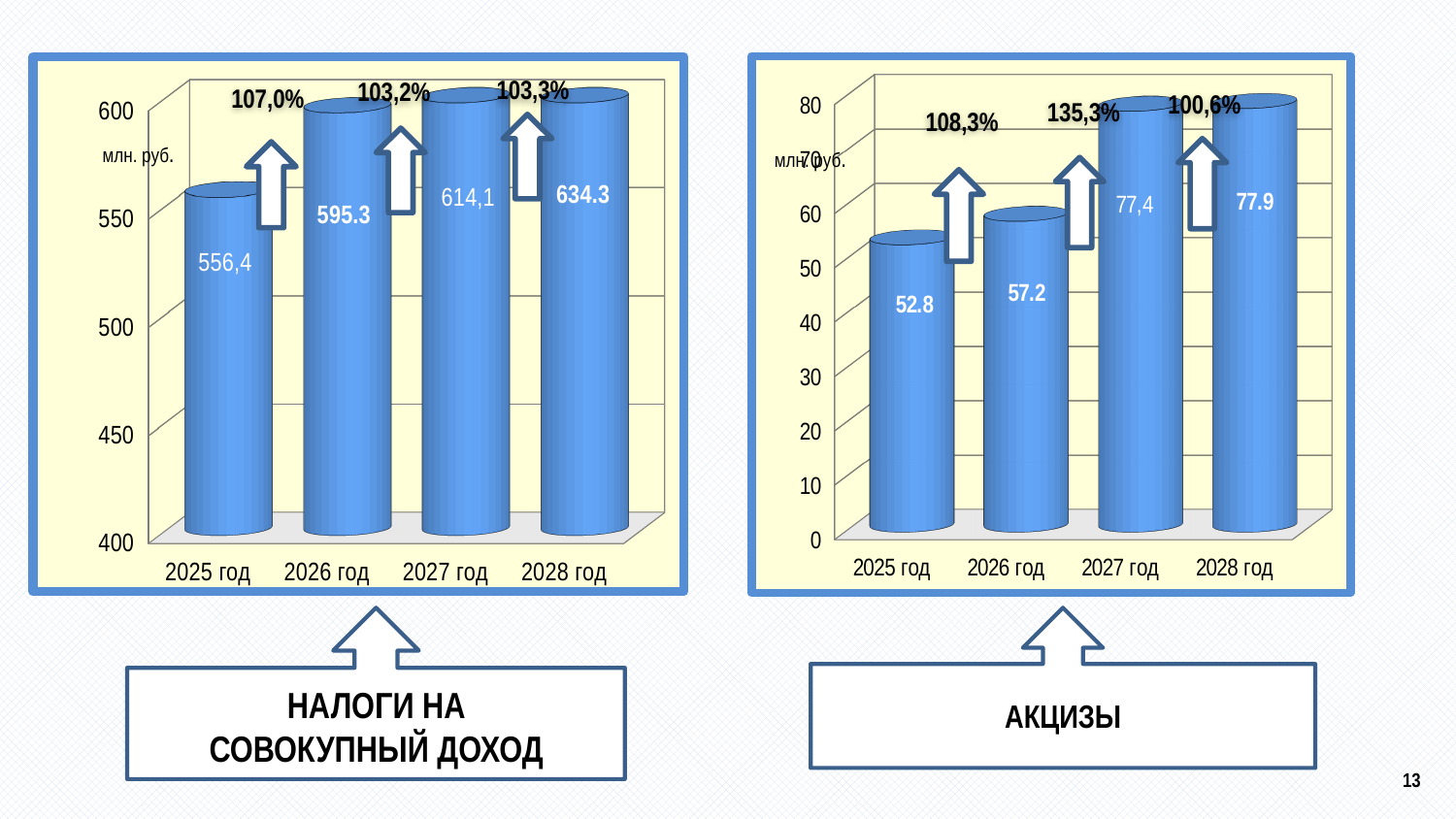
In the left chart (НАЛОГИ НА СОВОКУПНЫЙ ДОХОД), is the value for 2026 год greater or less than 600? less In the right chart (АКЦИЗЫ), which is larger: the value for 2026 год or 2027 год? 2027 год In the right chart (АКЦИЗЫ), what is the value for 2026 год? 57.2 In the right chart (АКЦИЗЫ), what is the value for 2028 год? 77.9 In the right chart (АКЦИЗЫ), which year has the lowest value? 2025 год In the left chart (НАЛОГИ НА СОВОКУПНЫЙ ДОХОД), what is the value for 2027 год? 614,1 In the right chart (АКЦИЗЫ), what is the difference between the values for 2026 год and 2025 год? 4.4 How many years are shown on the x axis of the right chart (АКЦИЗЫ)? 4 In the left chart (НАЛОГИ НА СОВОКУПНЫЙ ДОХОД), what is the value for 2025 год? 556,4 In the left chart (НАЛОГИ НА СОВОКУПНЫЙ ДОХОД), which year has the highest value? 2028 год What type of chart is the left chart (НАЛОГИ НА СОВОКУПНЫЙ ДОХОД)? bar chart In the left chart (НАЛОГИ НА СОВОКУПНЫЙ ДОХОД), what is the difference between the values for 2028 год and 2026 год? 39